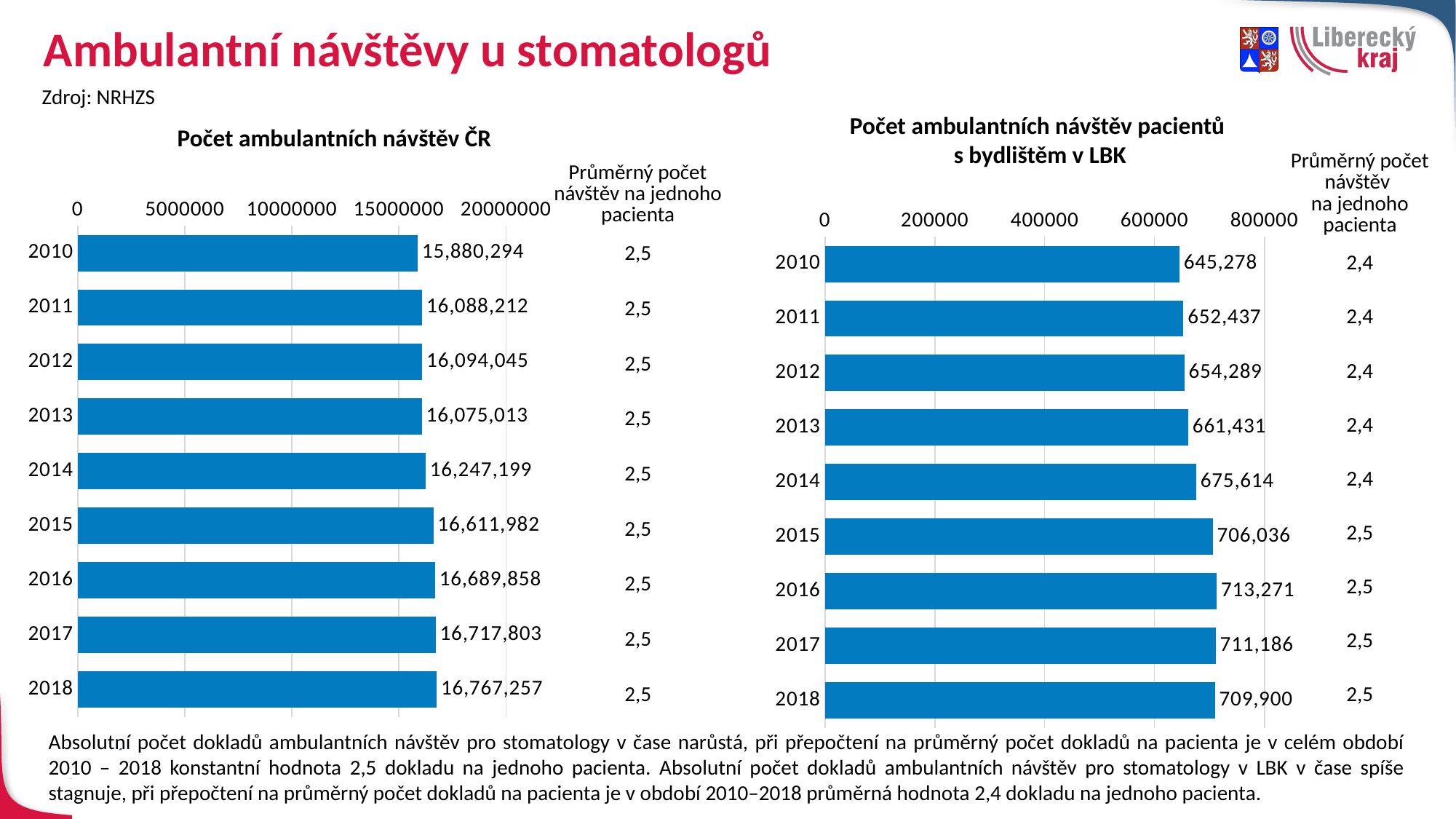
In the chart 'Počet ambulantních návštěv pacientů s bydlištěm v LBK', which is larger, the value for 2017 or the value for 2018? 2017 In the chart 'Počet ambulantních návštěv pacientů s bydlištěm v LBK', what is the value for 2016? 713,271 In the chart 'Počet ambulantních návštěv pacientů s bydlištěm v LBK', is the value for 2015 greater or less than 600000? greater How many years are shown in the chart 'Počet ambulantních návštěv ČR'? 9 In the chart 'Počet ambulantních návštěv ČR', which year has the highest value? 2018 What kind of chart is 'Počet ambulantních návštěv pacientů s bydlištěm v LBK'? bar chart In the chart 'Počet ambulantních návštěv pacientů s bydlištěm v LBK', which year has the lowest value? 2010 In the chart 'Počet ambulantních návštěv pacientů s bydlištěm v LBK', which year has the highest value? 2016 In the chart 'Počet ambulantních návštěv ČR', which year has the lowest value? 2010 In the chart 'Počet ambulantních návštěv ČR', what is the value for 2018? 16,767,257 In the chart 'Počet ambulantních návštěv ČR', what is the value for 2010? 15,880,294 In the chart 'Počet ambulantních návštěv ČR', what is the difference between the values for 2018 and 2010? 886,963